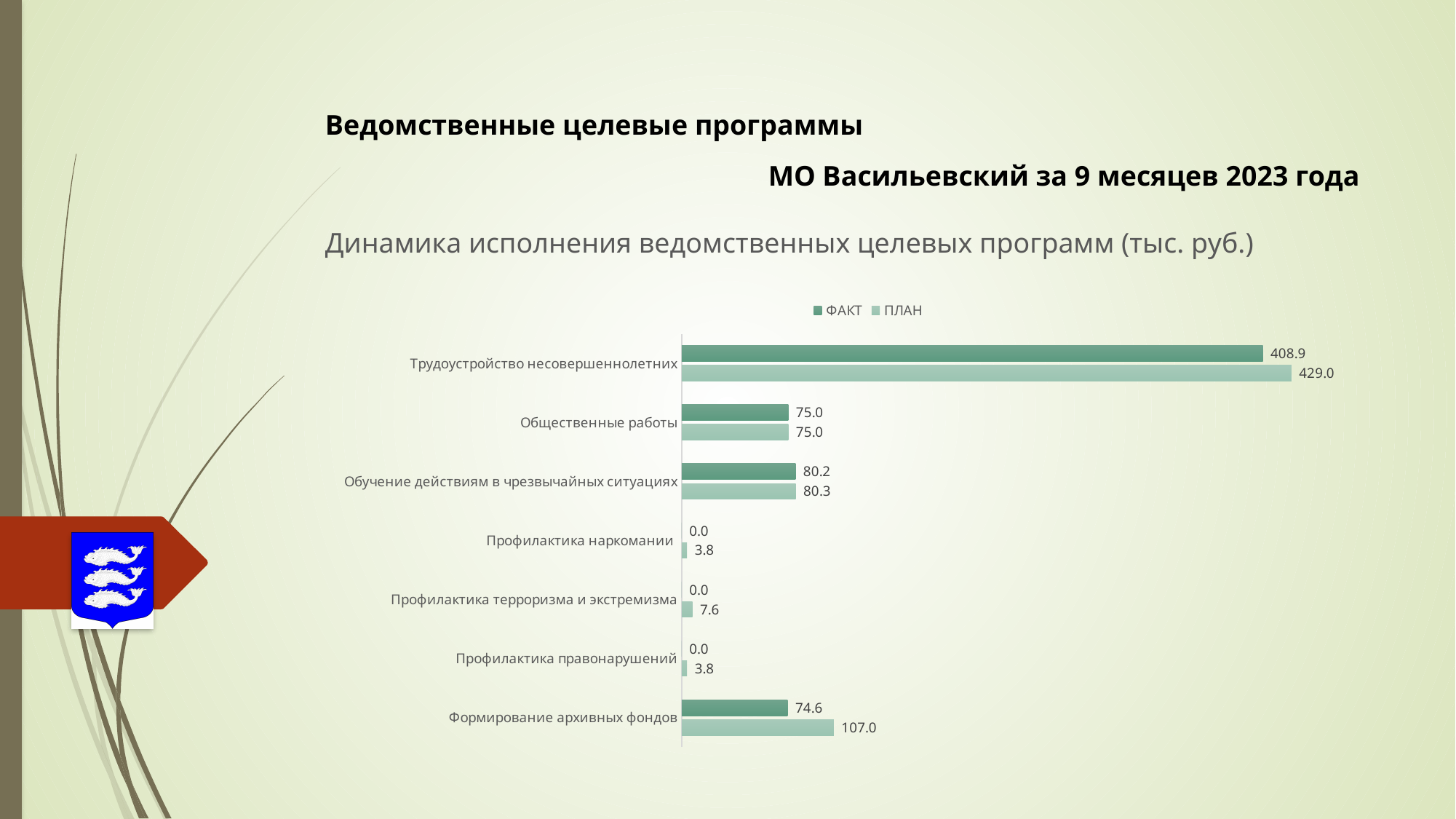
Which category has the highest ПЛАН value? Трудоустройство несовершеннолетних What is the difference between the ПЛАН and ФАКТ values for Формирование архивных фондов? 32.4 What is the ПЛАН value for Профилактика терроризма и экстремизма? 7.6 How many series does the legend list? 2 What is the ПЛАН value for Формирование архивных фондов? 107.0 Which category has the lowest ПЛАН value? Профилактика наркомании and Профилактика правонарушений (3.8) How many categories are shown in the chart? 7 What is the difference between the ПЛАН and ФАКТ values for Трудоустройство несовершеннолетних? 20.1 What are the two series named in the legend? ФАКТ and ПЛАН Which is larger for Формирование архивных фондов, the ФАКТ value or the ПЛАН value? ПЛАН What is the ФАКТ value for Трудоустройство несовершеннолетних? 408.9 What kind of chart is shown on the slide? Bar chart